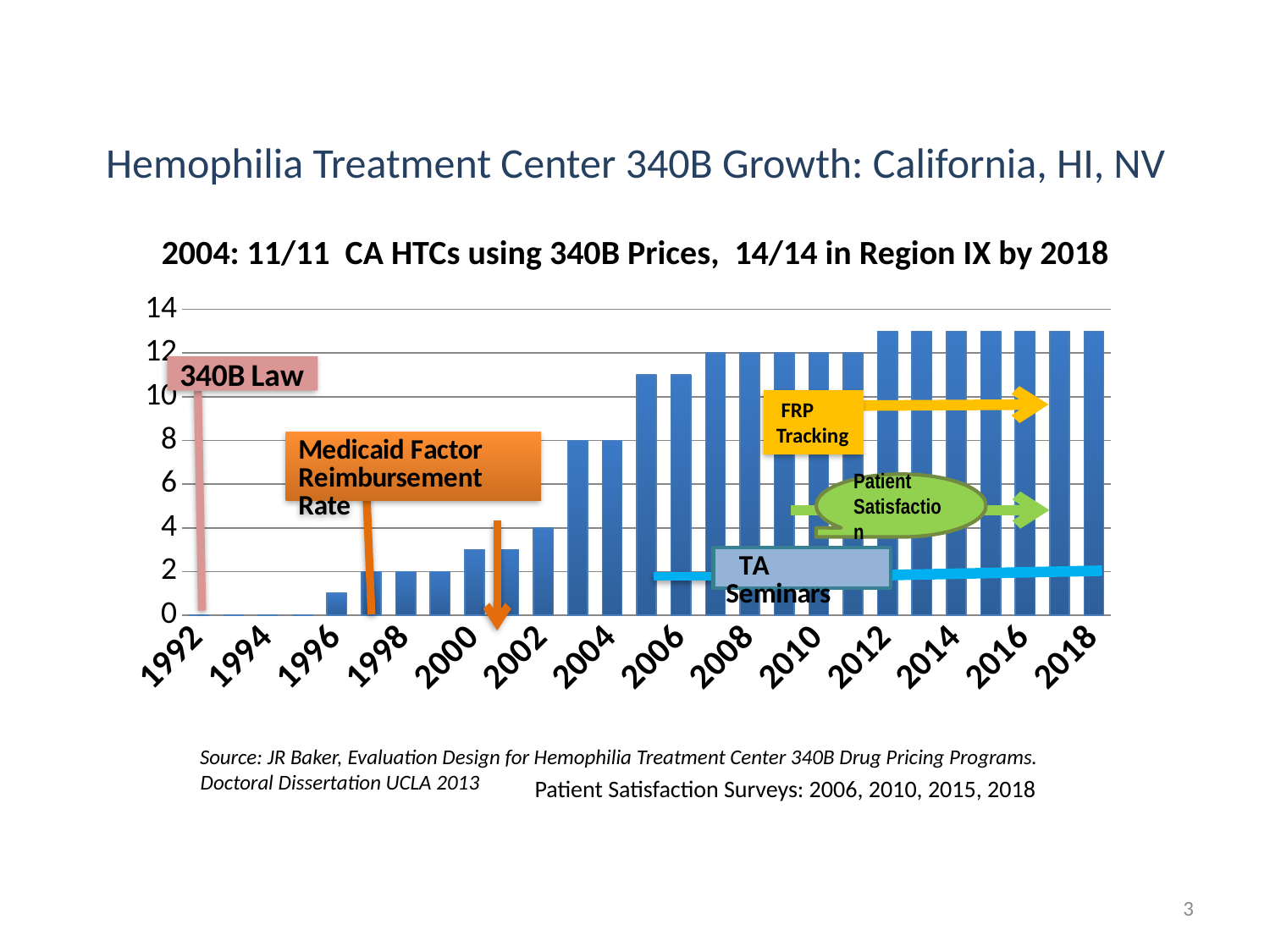
Do the values generally rise or fall from 1992 to 2018? rise Which is larger, the value for 2004 or the value for 2010? 2010 What is the value for 2008? 12 What is the value for 2002? 4 Is the value for 1996 greater or less than 2? less What kind of chart is shown on the slide? bar chart Is the value for 2006 greater or less than 10? greater Is the value for 2018 greater or less than 12? greater What is the value for 2004? 8 What is the difference between the values for 2008 and 2004? 4 What is the value for 1998? 2 What is the title of the chart? 2004: 11/11 CA HTCs using 340B Prices, 14/14 in Region IX by 2018